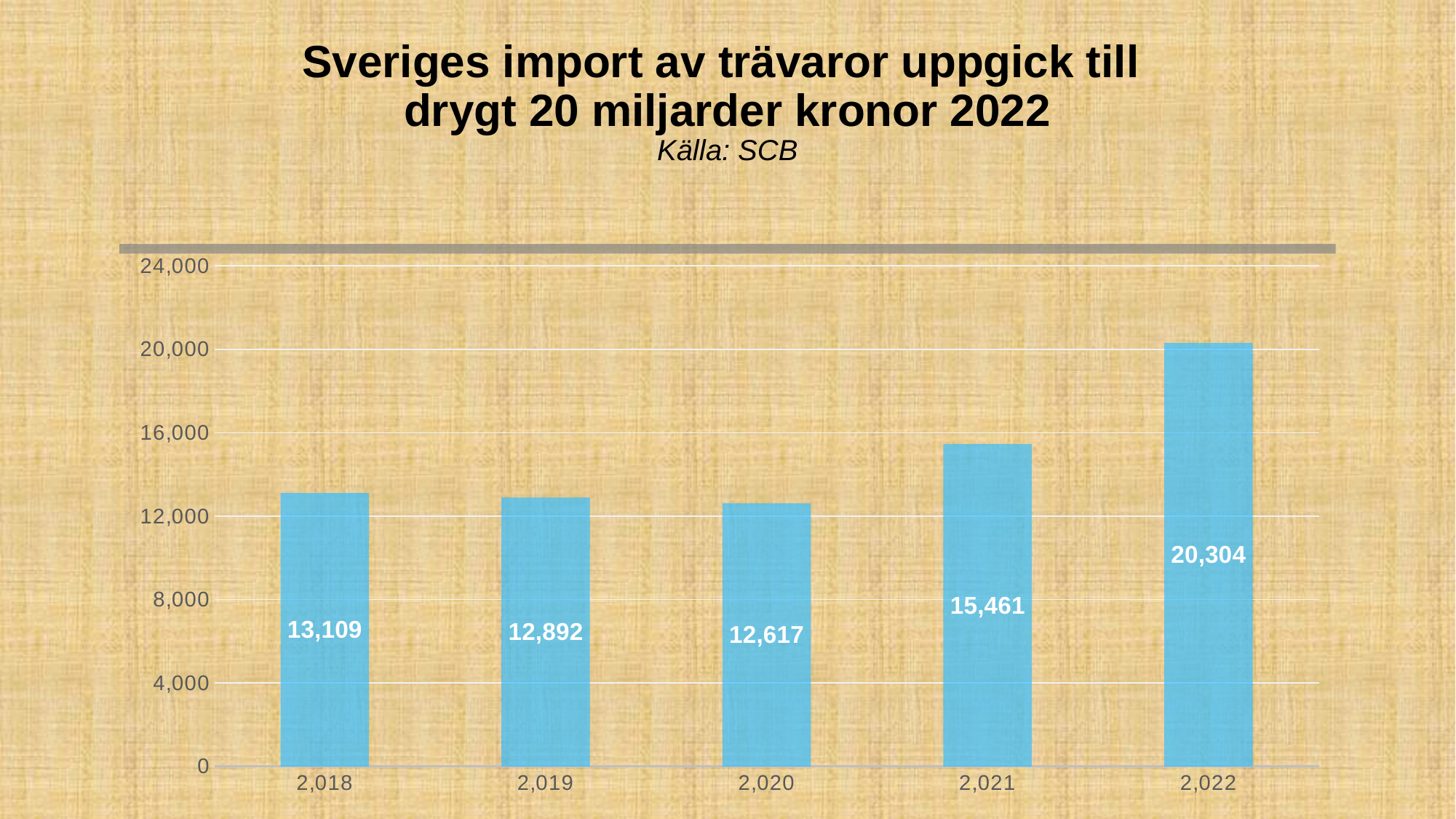
What is the value for 2,022? 20,304 How many bars are shown in the chart? 5 Which year has the highest value? 2,022 What is the value for 2,018? 13,109 What source is cited below the chart title? SCB What is the difference between the values for 2,018 and 2,019? 217 Which year has the lowest value? 2,020 What is the difference between the values for 2,022 and 2,021? 4,843 Is the value for 2,022 greater or less than 20,000? greater What is the value for 2,020? 12,617 Which is larger, the value for 2,021 or the value for 2,019? 2,021 What kind of chart is shown on the slide? bar chart